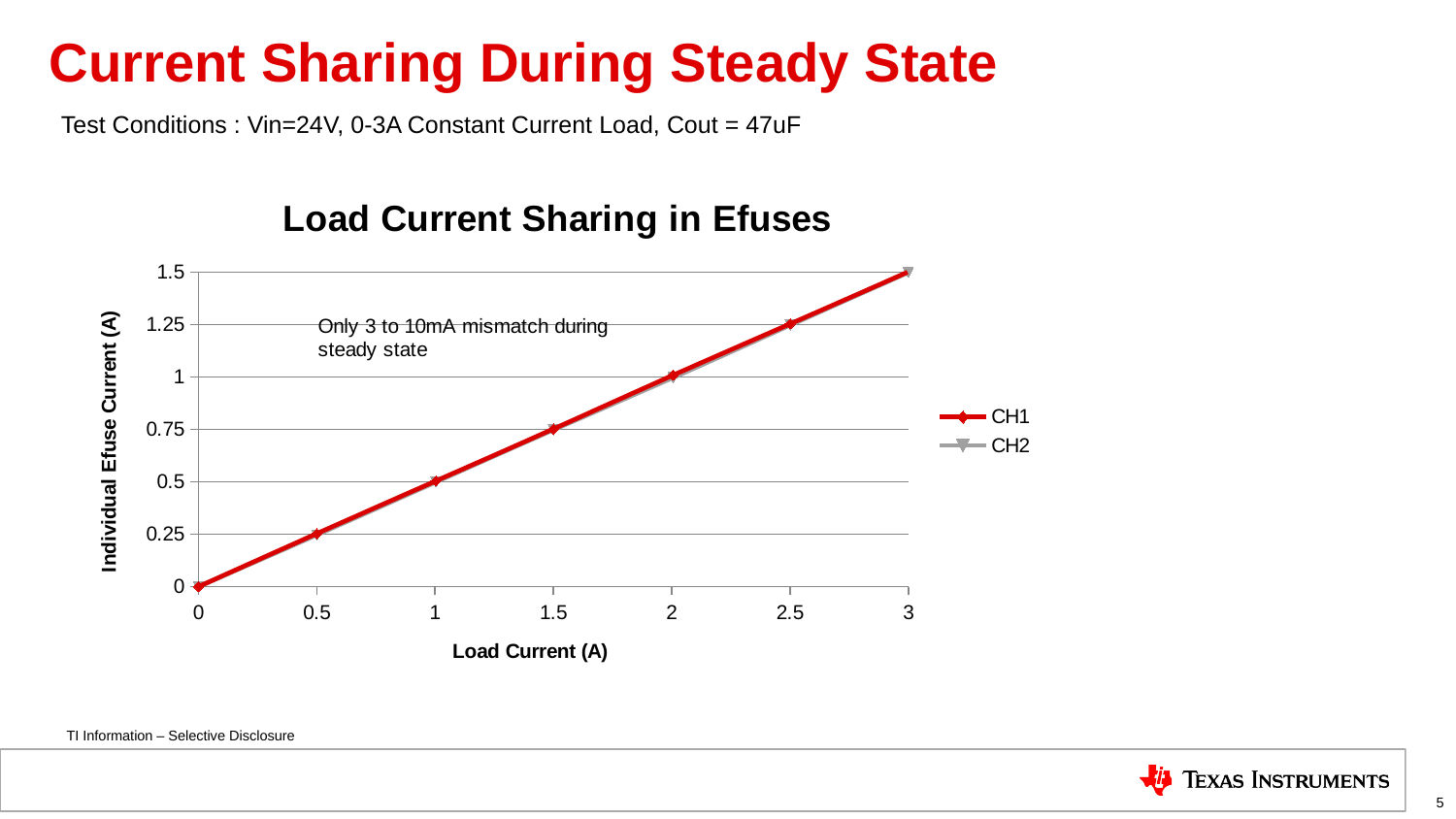
How many series does the legend list? 2 What is the title of the chart? Load Current Sharing in Efuses Do the values of CH1 rise or fall as Load Current increases along the x axis? rise Is the CH1 value at a Load Current of 3 A greater or less than 1.25? greater At which Load Current value is the CH2 series lowest? 0 Is the CH1 value at a Load Current of 2 A greater or less than 0.75? greater What are the names of the two series in the legend? CH1 and CH2 Is the CH2 value at a Load Current of 0.5 A greater or less than 0.5? less How many data points are plotted for the CH1 series? 7 What kind of chart is shown on the slide? line chart At which Load Current value is the CH1 series highest? 3